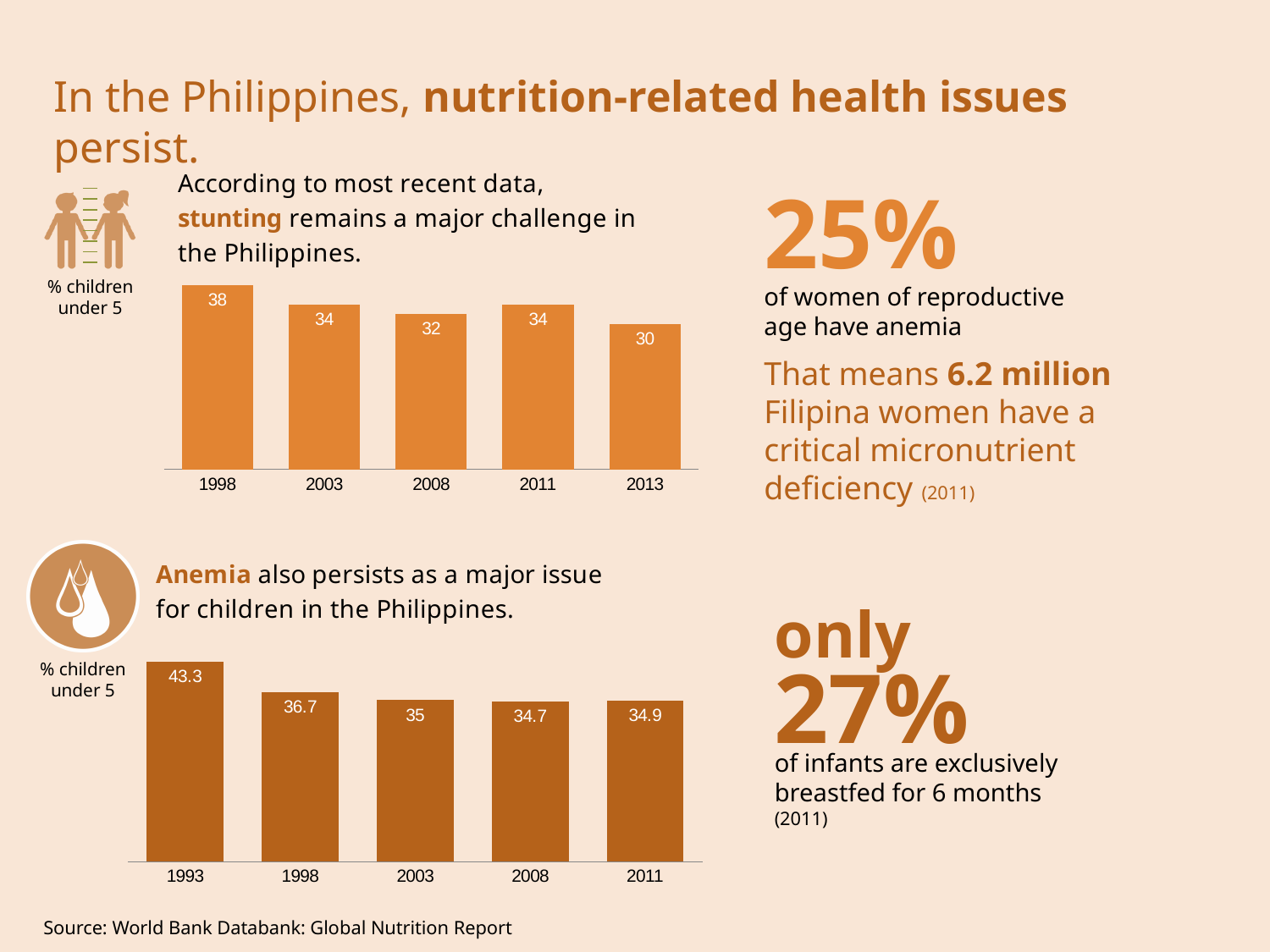
In the stunting chart (top), what is the value for 1998? 38 In the anemia chart (bottom), is the value for 2003 larger or smaller than the value for 1998? smaller In the anemia chart (bottom), what is the difference between the 1993 value and the 1998 value? 6.6 In the stunting chart (top), what is the value for 2013? 30 In the stunting chart (top), how many years are shown? 5 In the stunting chart (top), what is the difference between the 1998 value and the 2013 value? 8 In the stunting chart (top), which year has the highest value? 1998 In the anemia chart (bottom), what is the value for 2008? 34.7 In the anemia chart (bottom), which year has the highest value? 1993 In the anemia chart (bottom), what is the value for 1993? 43.3 In the stunting chart (top), which year has the lowest value? 2013 What kind of chart is the anemia chart (bottom)? bar chart